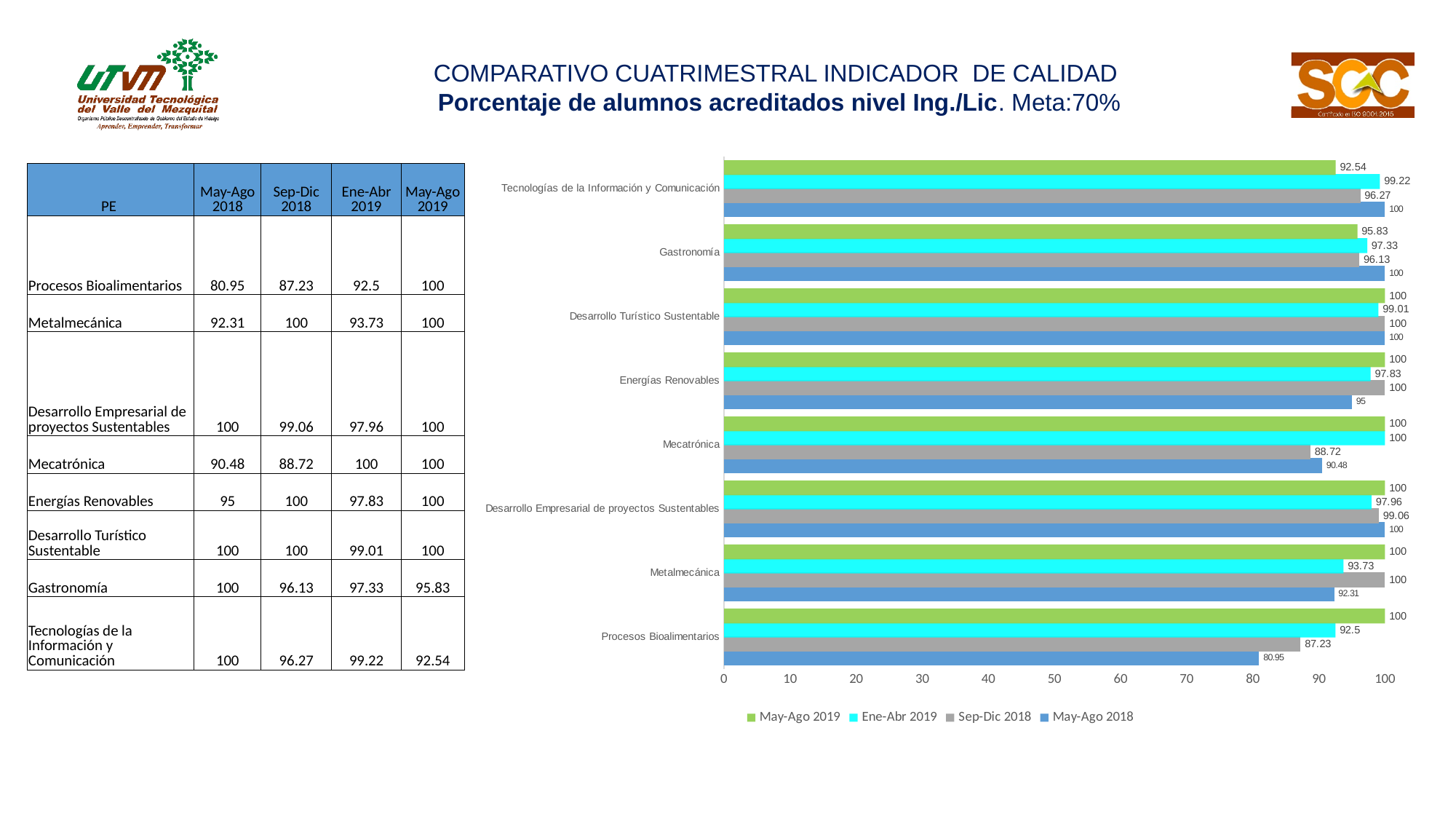
What is the difference between the May-Ago 2019 and May-Ago 2018 values for Procesos Bioalimentarios? 19.05 What is the May-Ago 2018 value for Procesos Bioalimentarios? 80.95 What is the difference between the Ene-Abr 2019 and Sep-Dic 2018 values for Mecatrónica? 11.28 How many categories (PE) are shown on the chart? 8 Is the May-Ago 2018 value for Energías Renovables greater or less than 90? greater Which category has the lowest May-Ago 2018 value? Procesos Bioalimentarios What is the Ene-Abr 2019 value for Tecnologías de la Información y Comunicación? 99.22 For Gastronomía, which is larger: the Ene-Abr 2019 value or the Sep-Dic 2018 value? Ene-Abr 2019 Which category has the lowest May-Ago 2019 value? Tecnologías de la Información y Comunicación How many series does the legend list? 4 What kind of chart is shown on the slide? bar chart What is the Sep-Dic 2018 value for Mecatrónica? 88.72